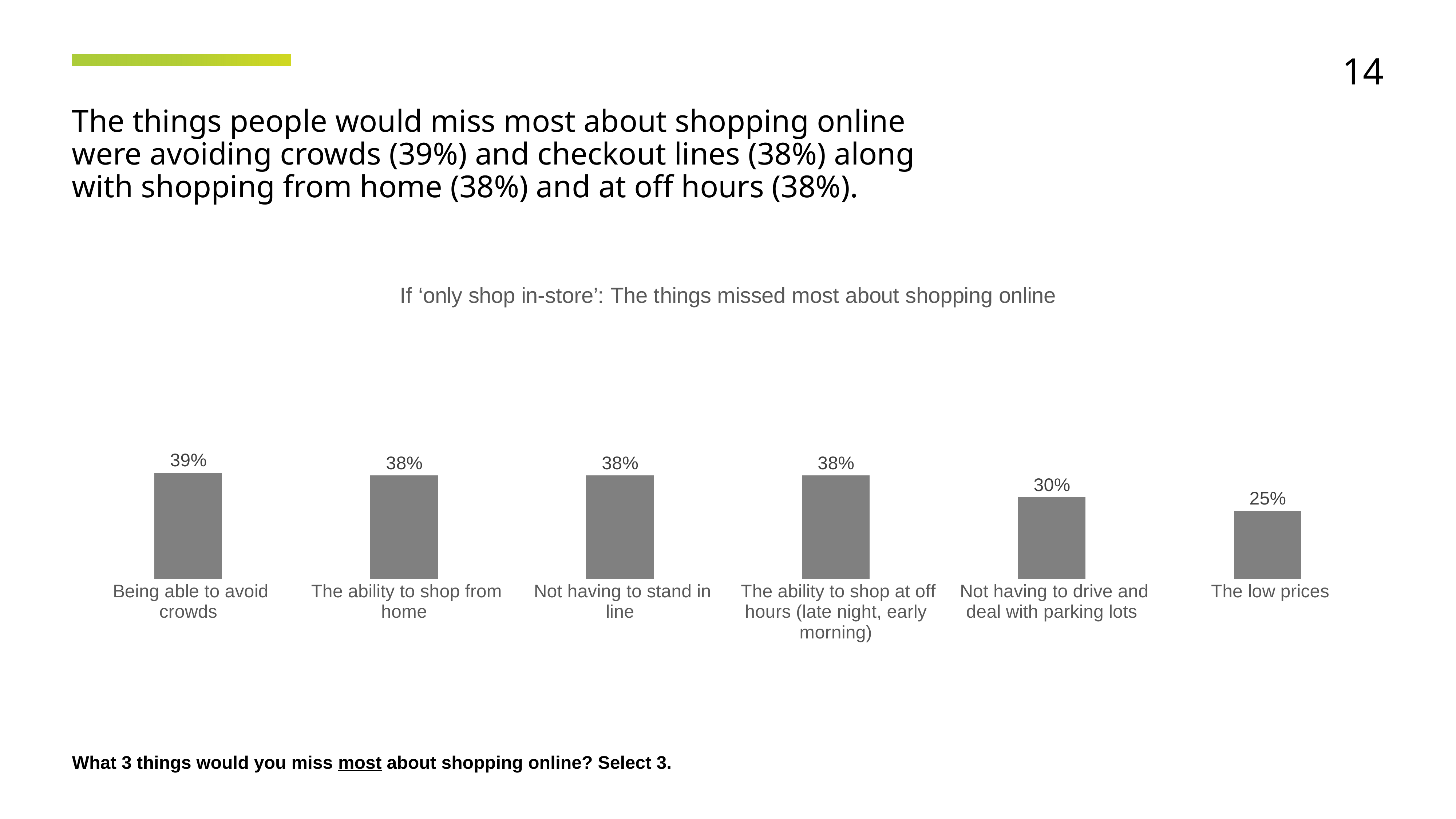
What is the value for 'Not having to stand in line'? 38% What is the title of the chart? If 'only shop in-store': The things missed most about shopping online What is the difference between 'Being able to avoid crowds' and 'The low prices'? 14% What is the difference between 'The ability to shop from home' and 'Not having to drive and deal with parking lots'? 8% What is the value for 'Being able to avoid crowds'? 39% What is the value for 'Not having to drive and deal with parking lots'? 30% What kind of chart is shown on the slide? Bar chart Which is larger: 'Not having to drive and deal with parking lots' or 'The low prices'? Not having to drive and deal with parking lots Which category has the lowest value? The low prices How many categories are shown in the chart? 6 What is the value for 'The low prices'? 25% Which category has the highest value? Being able to avoid crowds